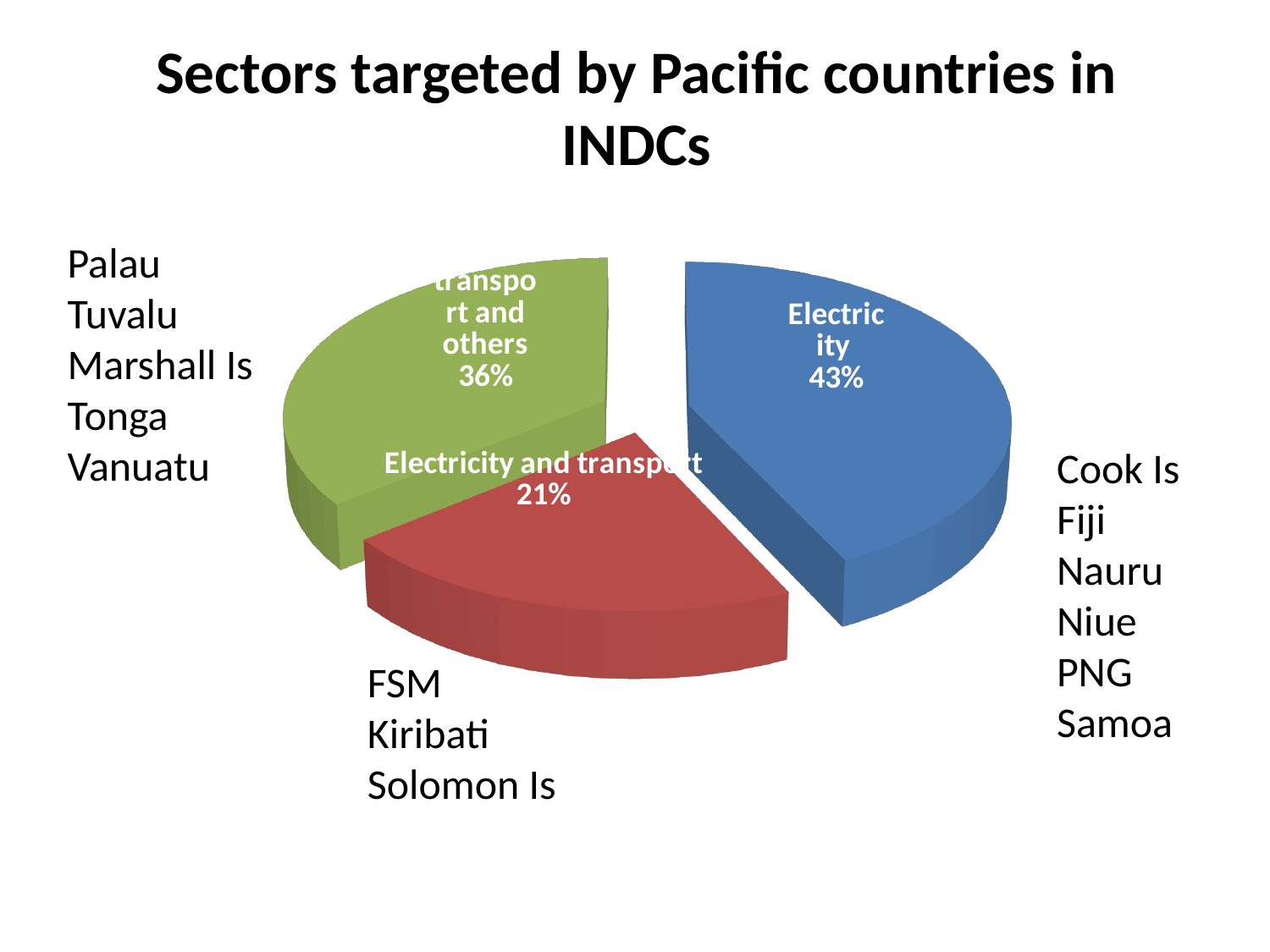
Which slice of the pie is the smallest? Electricity and transport What colour is the Electricity slice of the pie chart? blue What share of the pie does the Electricity and transport slice represent? 21% What percentage is shown on the green slice labelled 'transport and others'? 36% What is the title of the slide containing the pie chart? Sectors targeted by Pacific countries in INDCs What is the difference in percentage points between the green 'transport and others' slice (36%) and the Electricity and transport slice (21%)? 15 Which slice of the pie is the largest? Electricity What share of the pie does the Electricity slice represent? 43% How many slices does the pie chart have? 3 What is the difference in percentage points between the Electricity slice and the Electricity and transport slice? 22 Which is larger, the Electricity slice or the green 'transport and others' slice? Electricity What kind of chart is shown on the slide? pie chart